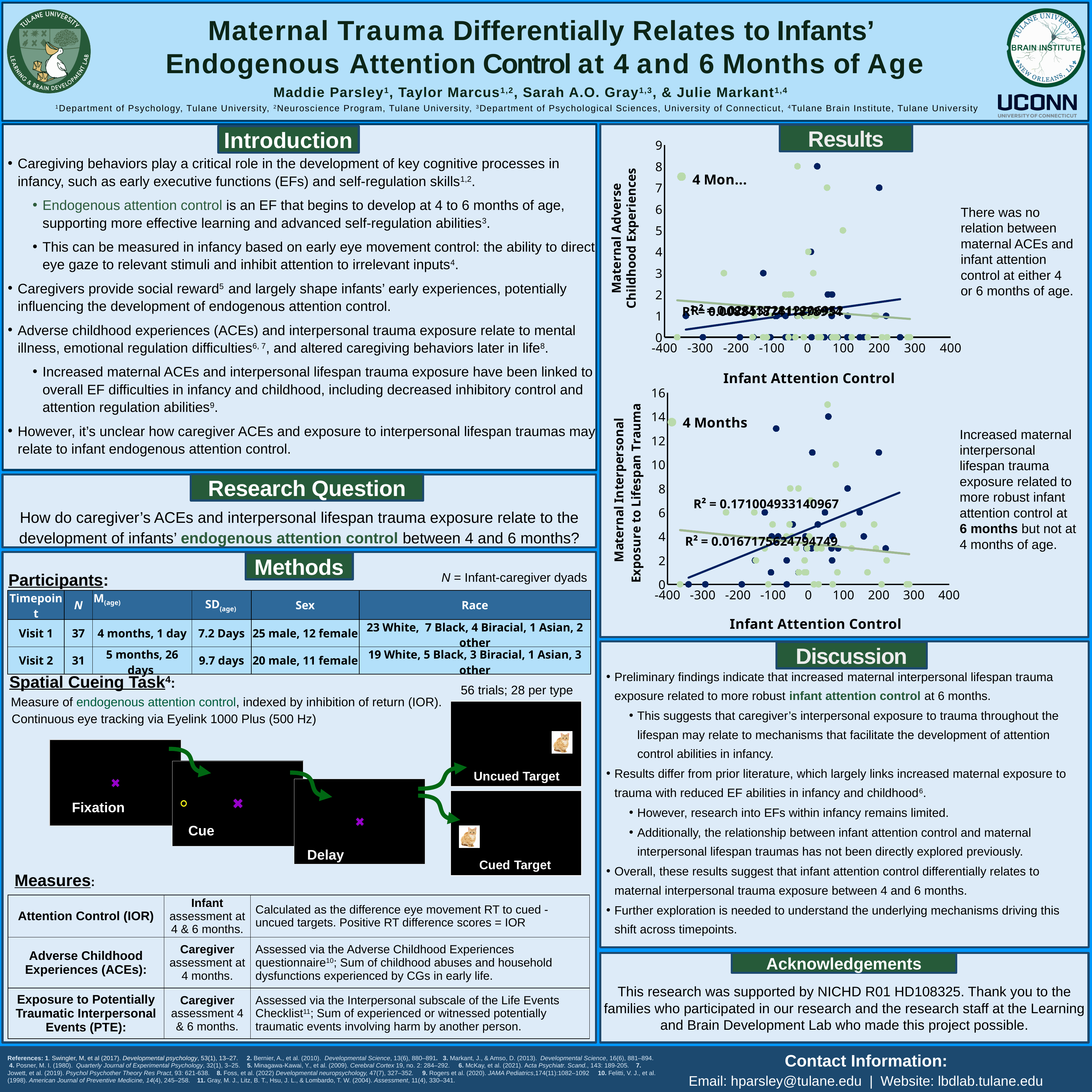
What kind of chart is the bottom chart in the Results section? Scatter chart In the bottom chart, what is the difference between the two R² values shown? 0.1542873706614921 In the bottom chart (Maternal Interpersonal Exposure to Lifespan Trauma), what is the R² value shown for the dark blue trend line? R² = 0.171004933140967 In the bottom chart, does the green trend line rise or fall as Infant Attention Control increases? Falls In the bottom chart (Maternal Interpersonal Exposure to Lifespan Trauma), what is the R² value shown for the green trend line? R² = 0.0167175624794749 What is the x-axis title of both charts in the Results section? Infant Attention Control In the bottom chart, does the dark blue trend line rise or fall as Infant Attention Control increases? Rises What kind of chart is the top chart in the Results section? Scatter chart In the top chart, is the highest plotted point greater or less than 6 on the y axis? greater In the bottom chart, is the highest plotted point greater or less than 14 on the y axis? greater In the bottom chart, which R² value is larger, 0.171004933140967 or 0.0167175624794749? 0.171004933140967 What is the y-axis title of the top chart in the Results section? Maternal Adverse Childhood Experiences